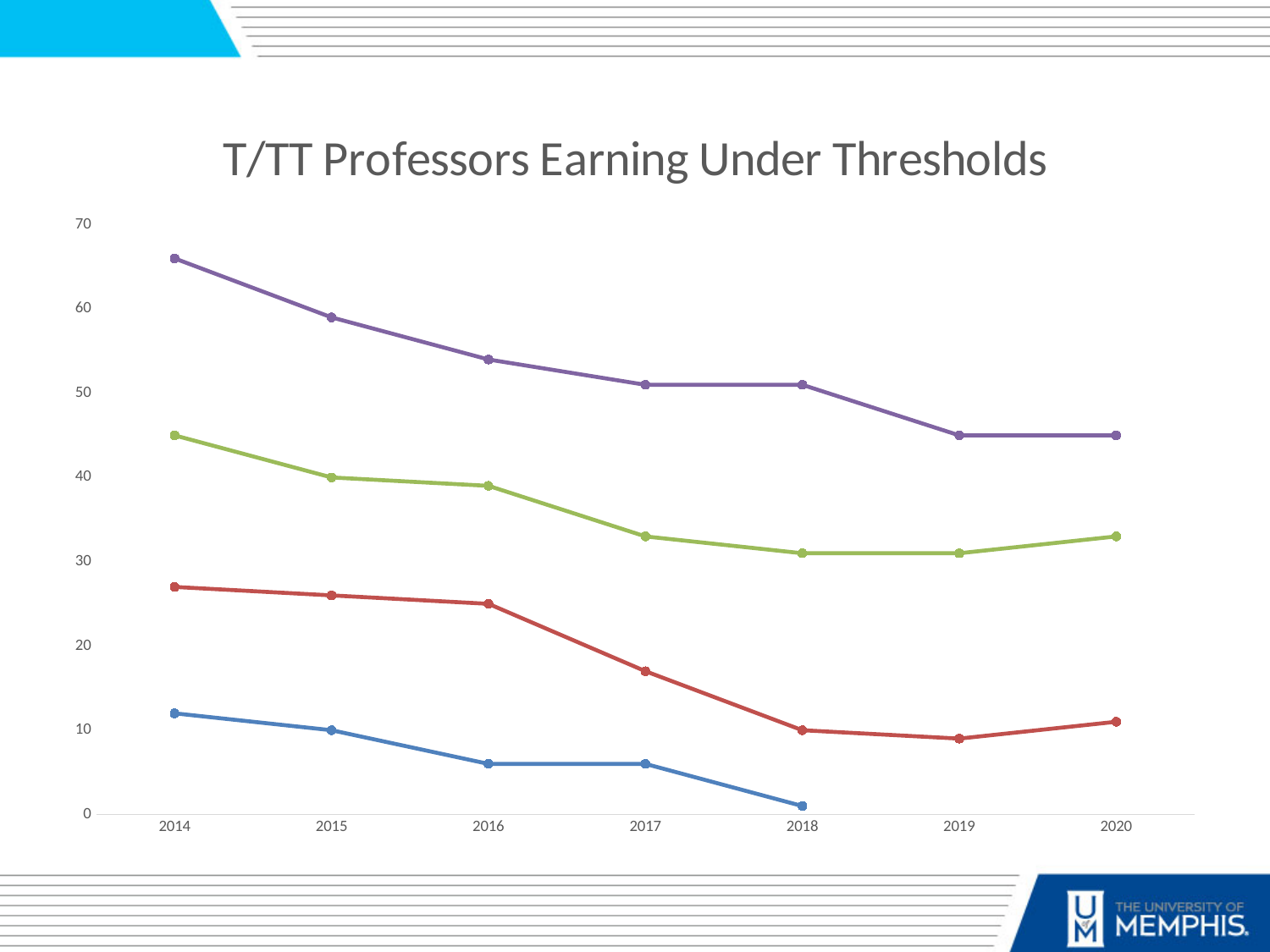
Is the value of the red line in 2017 greater or less than 20? less How many years are shown along the x axis of the chart? 7 Which line is highest across all years on the chart? the purple line Is the value of the purple line in 2014 greater or less than 60? greater Is the value of the blue line in 2018 greater or less than 10? less Does the purple line generally rise or fall from 2014 to 2020? fall How many lines are plotted on the chart? 4 Which line is lowest on the chart? the blue line In 2014, which is higher: the purple line or the green line? the purple line What kind of chart is shown on the slide? line chart What is the title of the chart? T/TT Professors Earning Under Thresholds